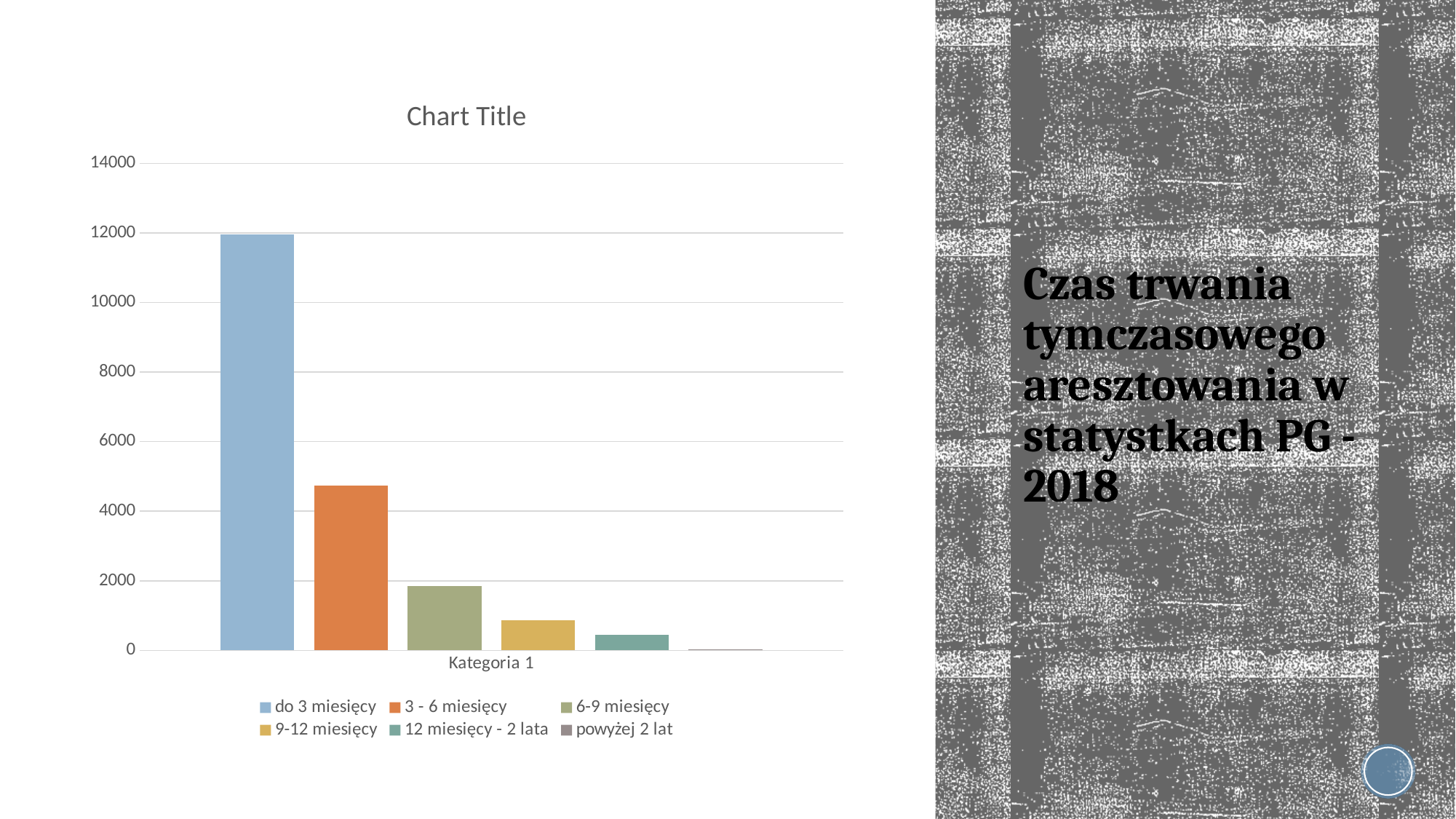
What is the title shown above the chart? Chart Title Which is larger, the value for '3 - 6 miesięcy' or the value for '6-9 miesięcy'? 3 - 6 miesięcy Is the value for 'do 3 miesięcy' greater or less than 10000? greater Which series has the highest value in the chart? do 3 miesięcy Is the value for '9-12 miesięcy' greater or less than 2000? less What kind of chart is shown on the slide? bar chart Which series has the lowest value in the chart? powyżej 2 lat How many series does the chart legend list? 6 Do the bar values rise or fall from left to right across the chart? fall Which is larger, the value for '12 miesięcy - 2 lata' or the value for 'powyżej 2 lat'? 12 miesięcy - 2 lata Is the value for '3 - 6 miesięcy' greater or less than 6000? less